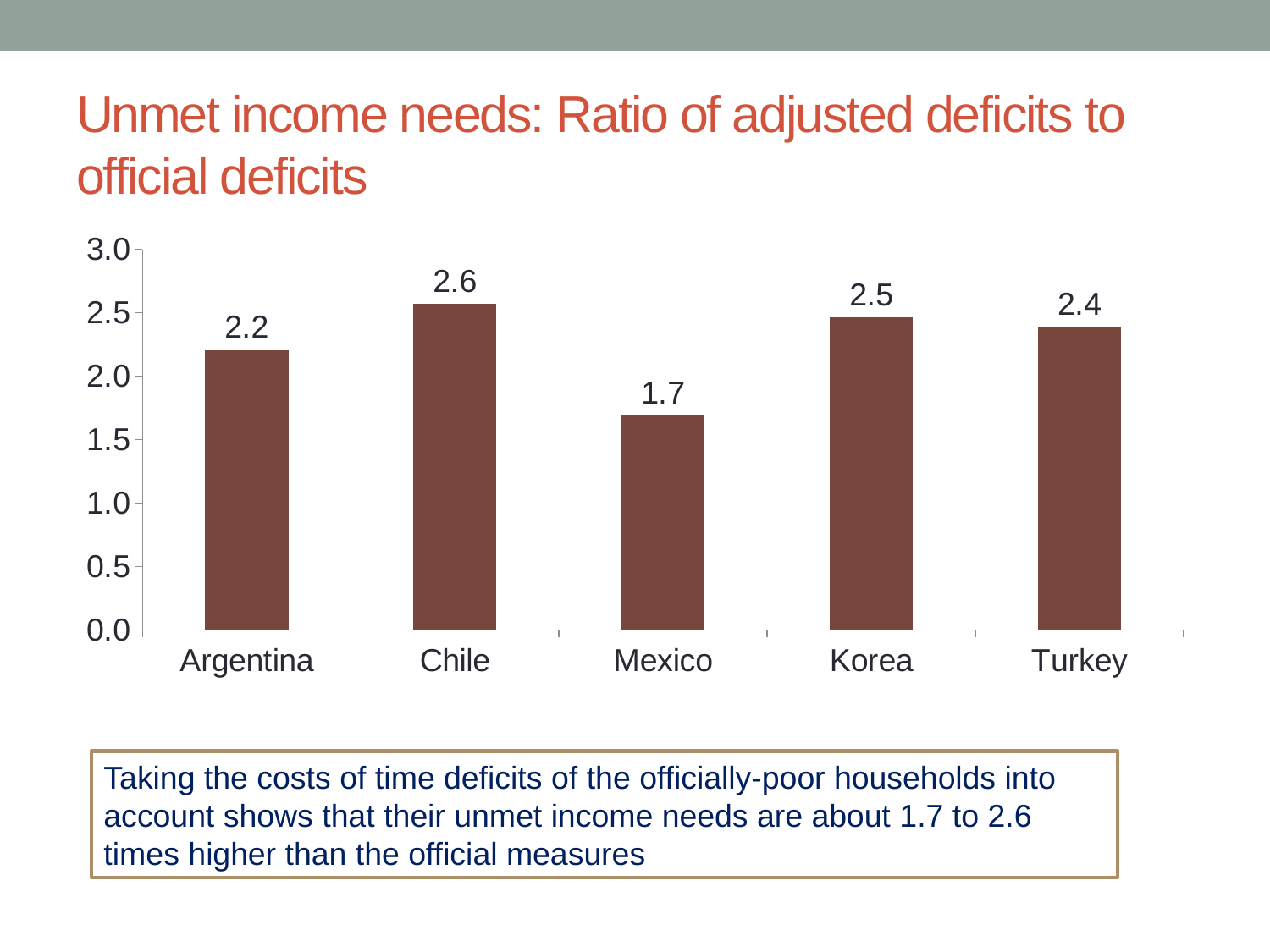
Which country has the lowest value? Mexico Which is larger, the value for Korea or the value for Argentina? Korea What is the difference between the values for Chile and Mexico? 0.9 What is the value for Korea? 2.5 What is the value for Turkey? 2.4 What kind of chart is shown on the slide? bar chart Is the value for Mexico greater or less than 2.0? less Which country has the highest value? Chile How many countries are shown on the chart? 5 What is the value for Mexico? 1.7 What is the title of the slide? Unmet income needs: Ratio of adjusted deficits to official deficits What is the value for Argentina? 2.2